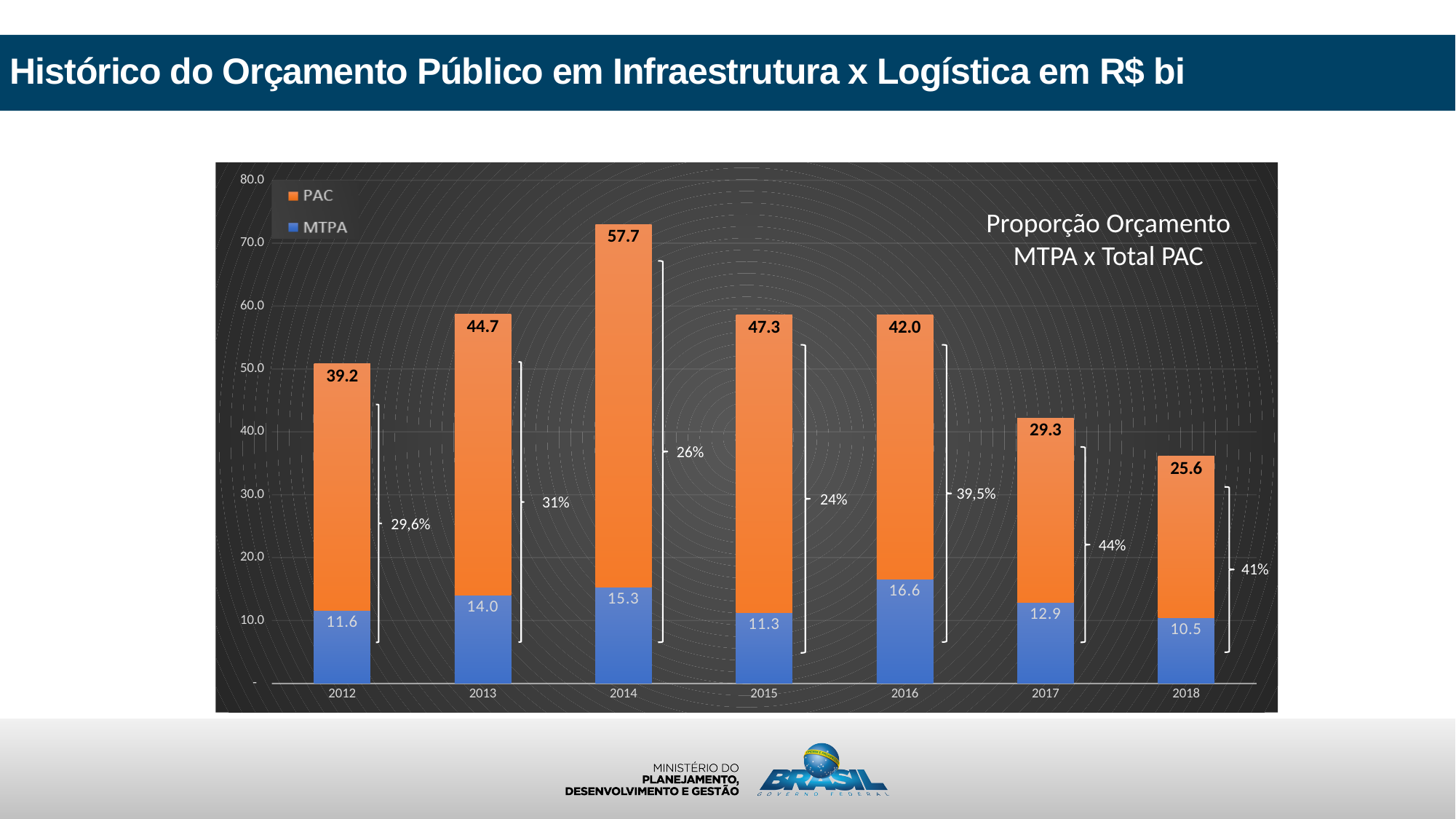
What is the MTPA value for 2018? 10.5 What percentage is shown next to the 2017 bar for the proportion MTPA x Total PAC? 44% What is the total of the stacked bar for 2012 (PAC plus MTPA)? 50.8 What is the difference between the PAC values for 2014 and 2018? 32.1 What kind of chart is shown on the slide? Stacked bar chart Which year has the highest PAC value? 2014 What is the PAC value for 2014? 57.7 How many years are shown on the x axis? 7 How many series does the legend list? 2 Which year has the lowest MTPA value? 2018 What is the MTPA value for 2016? 16.6 Which is larger, the MTPA value for 2013 or the MTPA value for 2017? 2013